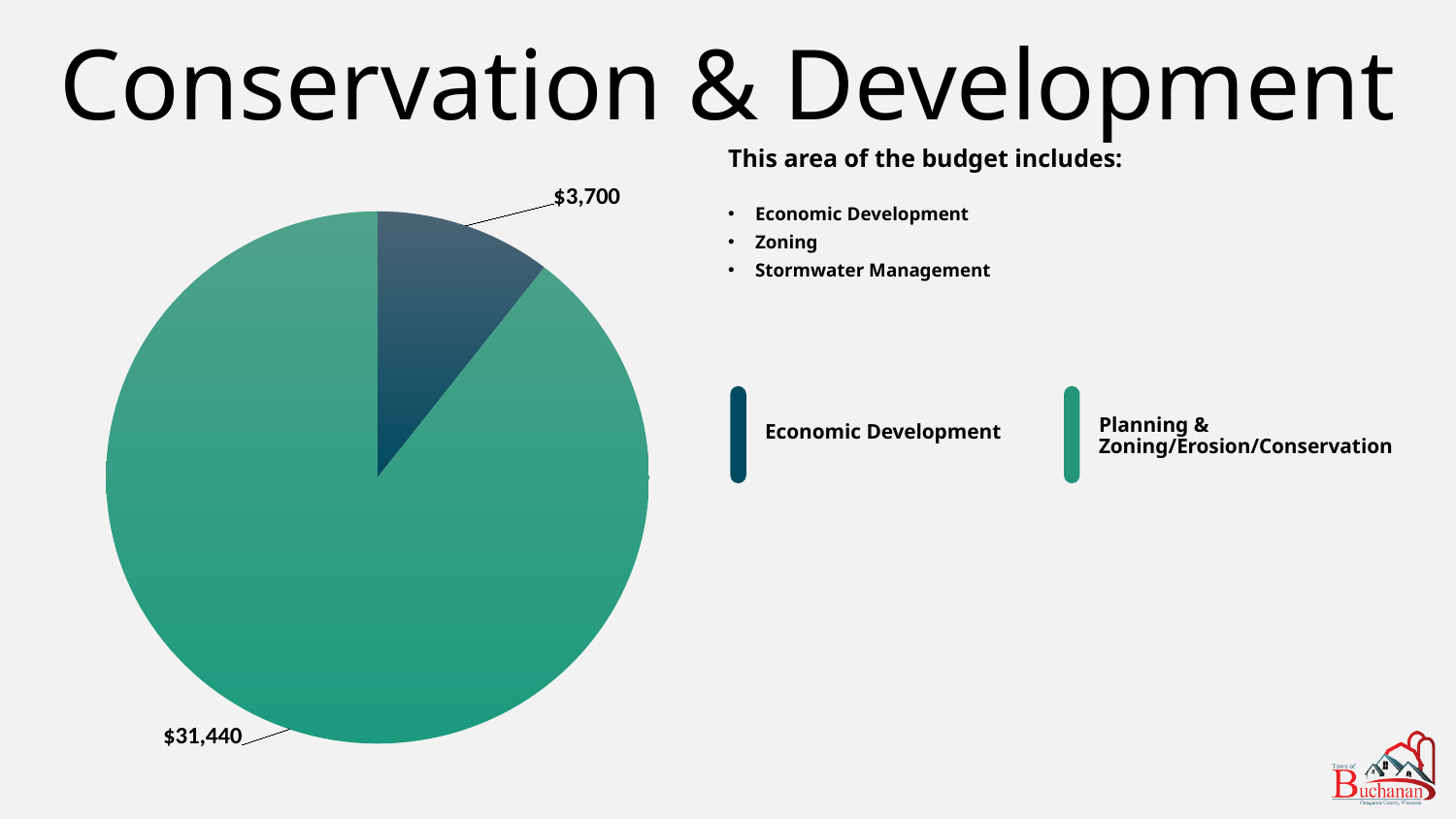
What kind of chart is shown on the slide? Pie chart How many slices does the pie chart have? 2 What is the difference between the Planning & Zoning/Erosion/Conservation value and the Economic Development value? $27,740 Which category has the smallest slice of the pie chart? Economic Development Which category has the largest slice of the pie chart? Planning & Zoning/Erosion/Conservation What is the total of the two values shown in the pie chart? $35,140 What is the value for Economic Development in the pie chart? $3,700 What colour is the Economic Development slice in the pie chart? Dark teal How many entries does the legend list? 2 Which is larger, Economic Development or Planning & Zoning/Erosion/Conservation? Planning & Zoning/Erosion/Conservation What is the value for Planning & Zoning/Erosion/Conservation in the pie chart? $31,440